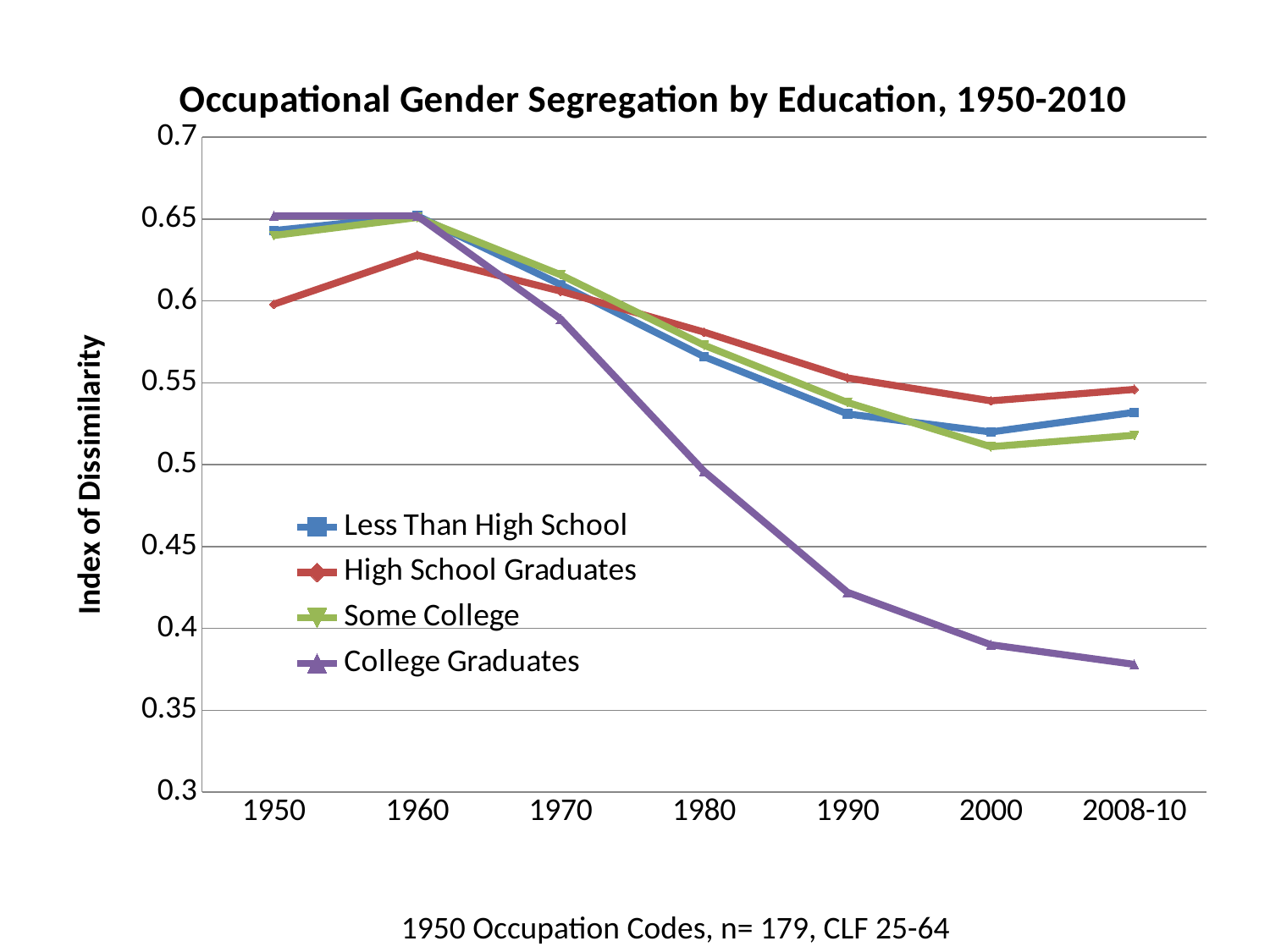
Is the value for College Graduates in 1990 greater or less than 0.45? less Does the College Graduates line rise or fall from 1960 to 2008-10? fall Which series has the highest value in 2008-10? High School Graduates What kind of chart is shown on the slide? line chart What is the title of the y axis? Index of Dissimilarity Is the value for College Graduates in 2008-10 greater or less than 0.4? less Is the value for Some College in 2000 greater or less than 0.55? less How many series does the legend list? 4 Which series has the lowest value in 2008-10? College Graduates Which series has the lowest value in 1950? High School Graduates How many time points are shown along the x axis? 7